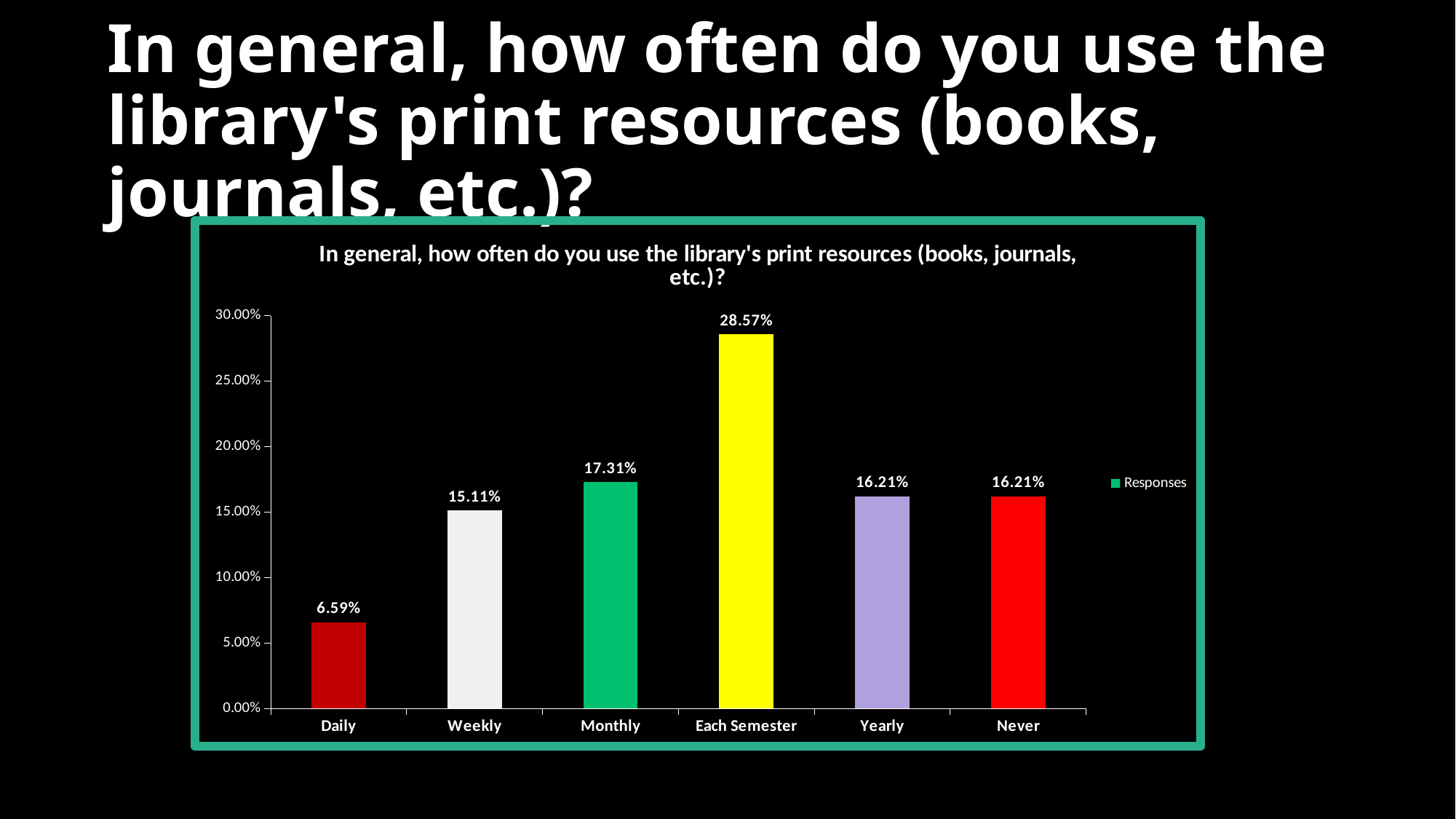
What is the value for Each Semester? 28.57% What is the value for Daily? 6.59% How many series does the legend list? 1 Which category has the highest value? Each Semester Is the value for Yearly greater or less than 20.00%? less How many categories are shown on the x axis? 6 Which category has the lowest value? Daily What is the value for Weekly? 15.11% What is the name of the series in the legend? Responses What is the difference between the values for Each Semester and Monthly? 11.26% Which is larger, the value for Monthly or the value for Weekly? Monthly What kind of chart is shown? bar chart